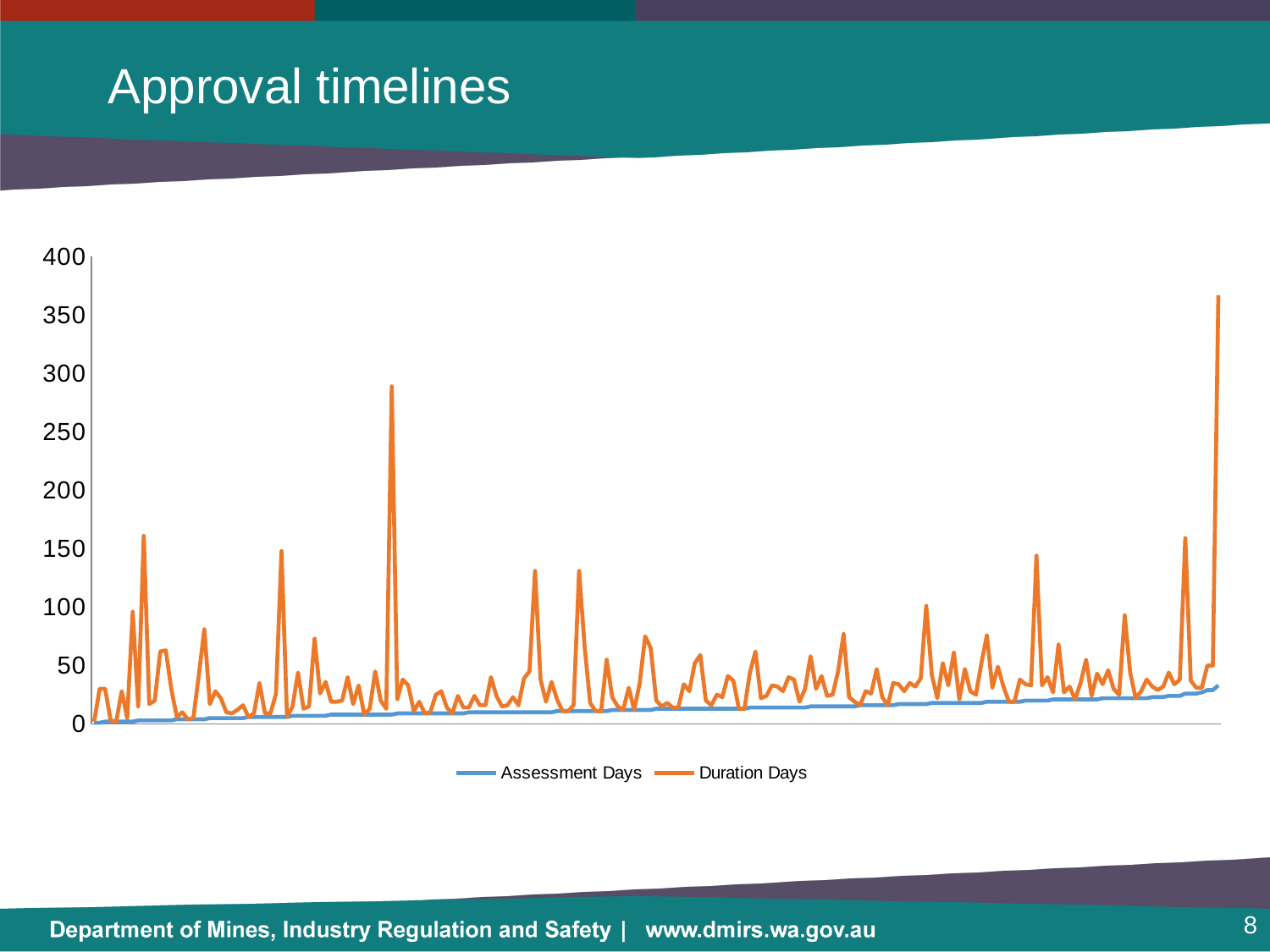
Does the Assessment Days line rise or fall from left to right? rise What kind of chart is shown on the slide? line chart Is the second-highest peak of the Duration Days series greater or less than 250? greater How many series does the legend list? 2 What is the title of the slide containing the chart? Approval timelines Which series reaches higher values overall, Assessment Days or Duration Days? Duration Days What is the maximum value shown on the vertical axis? 400 Is the highest peak of the Duration Days series greater or less than 400? less Which series is drawn in orange? Duration Days Is the highest value of the Assessment Days series greater or less than 50? less